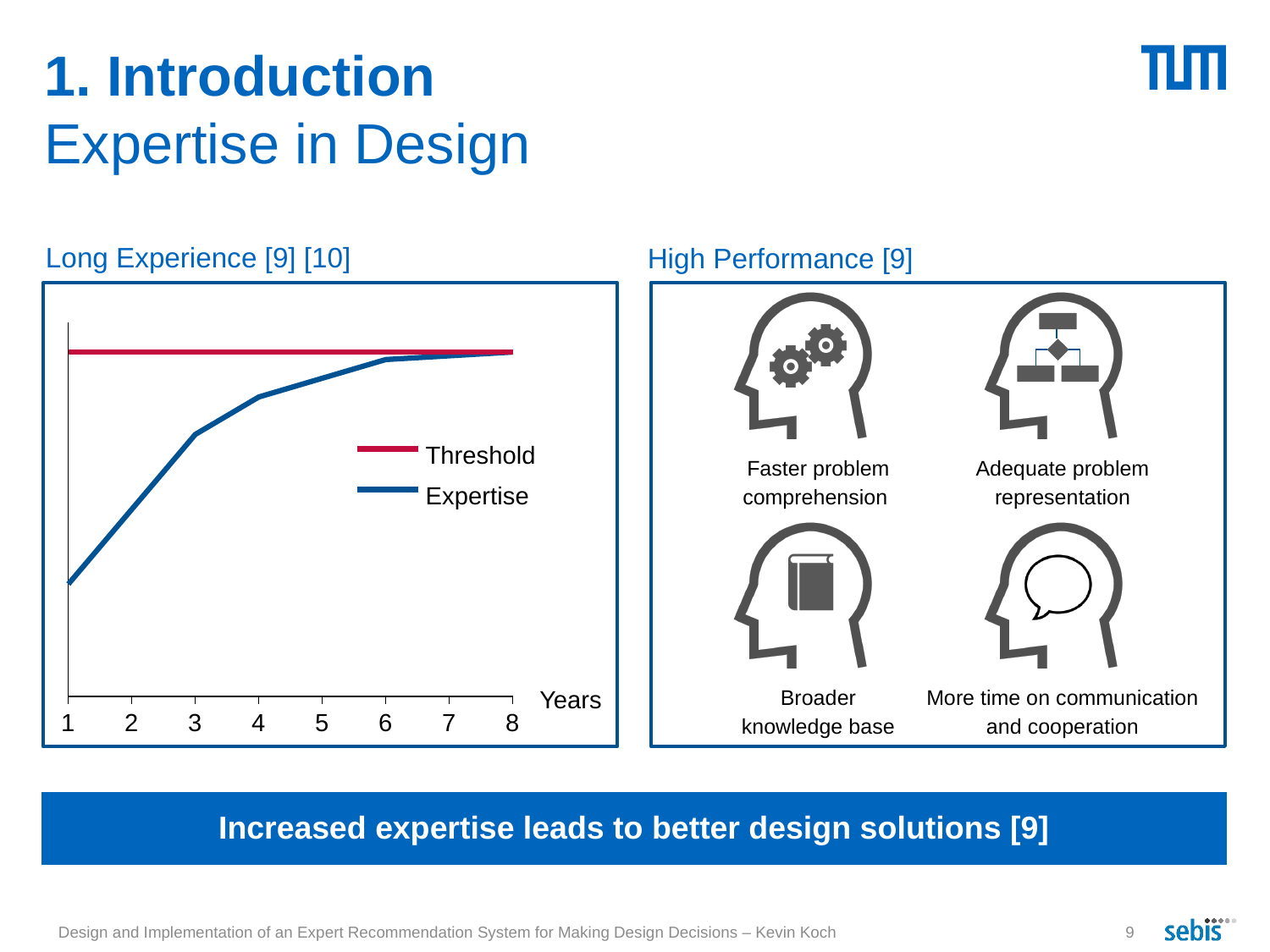
Does the Expertise line rise or fall as the years increase? Rises Is the Expertise value higher at year 2 or at year 4? Year 4 At which year is the Expertise line at its lowest? 1 At year 1, which is higher: the Threshold line or the Expertise line? Threshold Is the Expertise value higher at year 1 or at year 5? Year 5 How many series does the legend of the line chart list? 2 What are the two series named in the legend of the line chart? Threshold and Expertise Does the Threshold line rise, fall or stay flat across the years? Stays flat What is the label of the x axis of the line chart? Years How many year values are marked on the x axis of the line chart? 8 What kind of chart is shown under "Long Experience [9] [10]"? Line chart